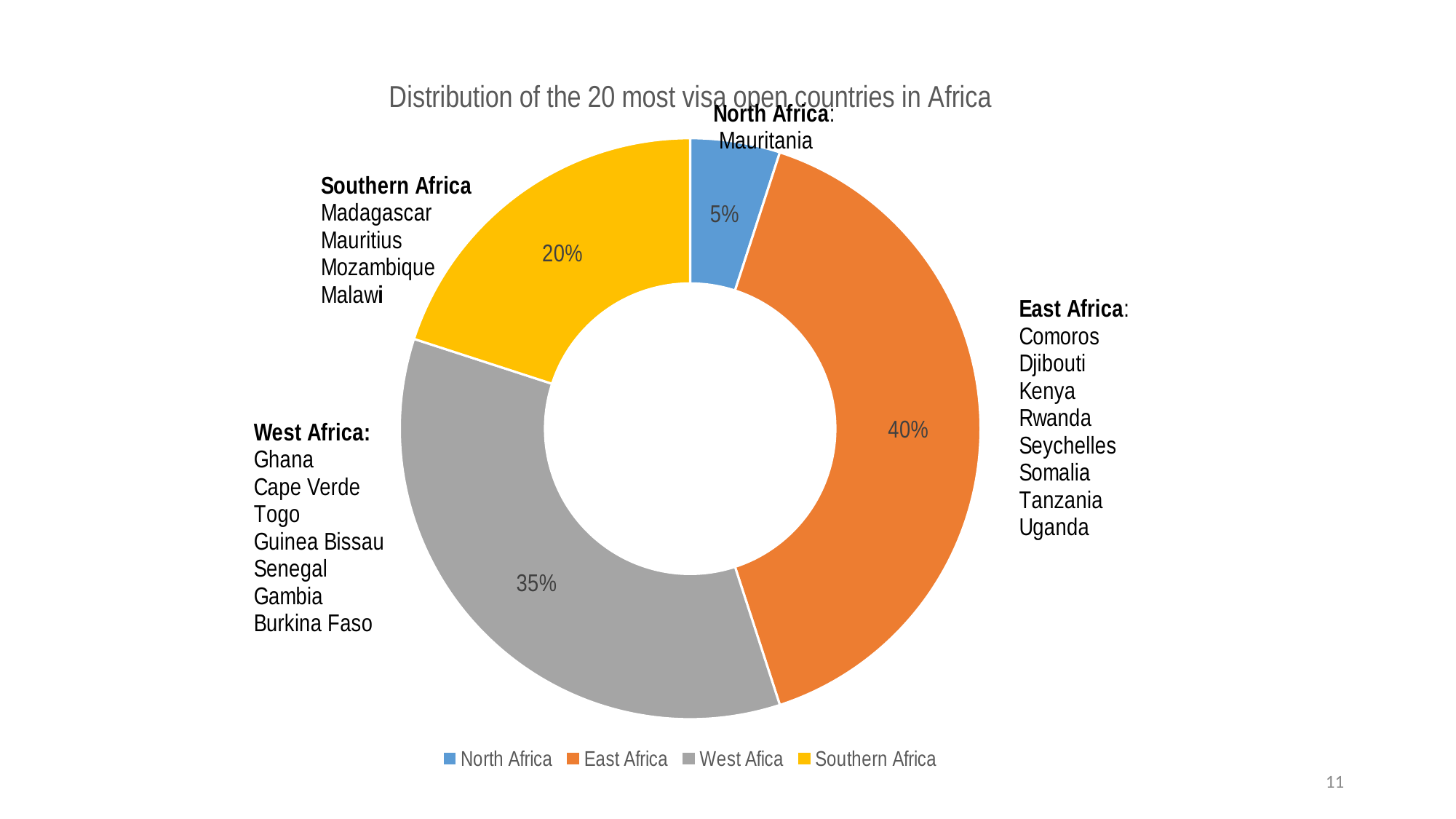
Which has a larger share, Southern Africa or North Africa? Southern Africa What share of the chart does East Africa account for? 40% Which region has the largest share of the chart? East Africa Which region has the smallest share of the chart? North Africa What kind of chart is shown on the slide? Doughnut chart What is the title of the chart? Distribution of the 20 most visa open countries in Africa What share of the chart does North Africa account for? 5% How many regions are shown in the chart? 4 What is the difference in percentage points between the East Africa and West Africa shares? 5 What colour is the East Africa segment of the chart? Orange What share of the chart does Southern Africa account for? 20% What share of the chart does West Africa account for? 35%